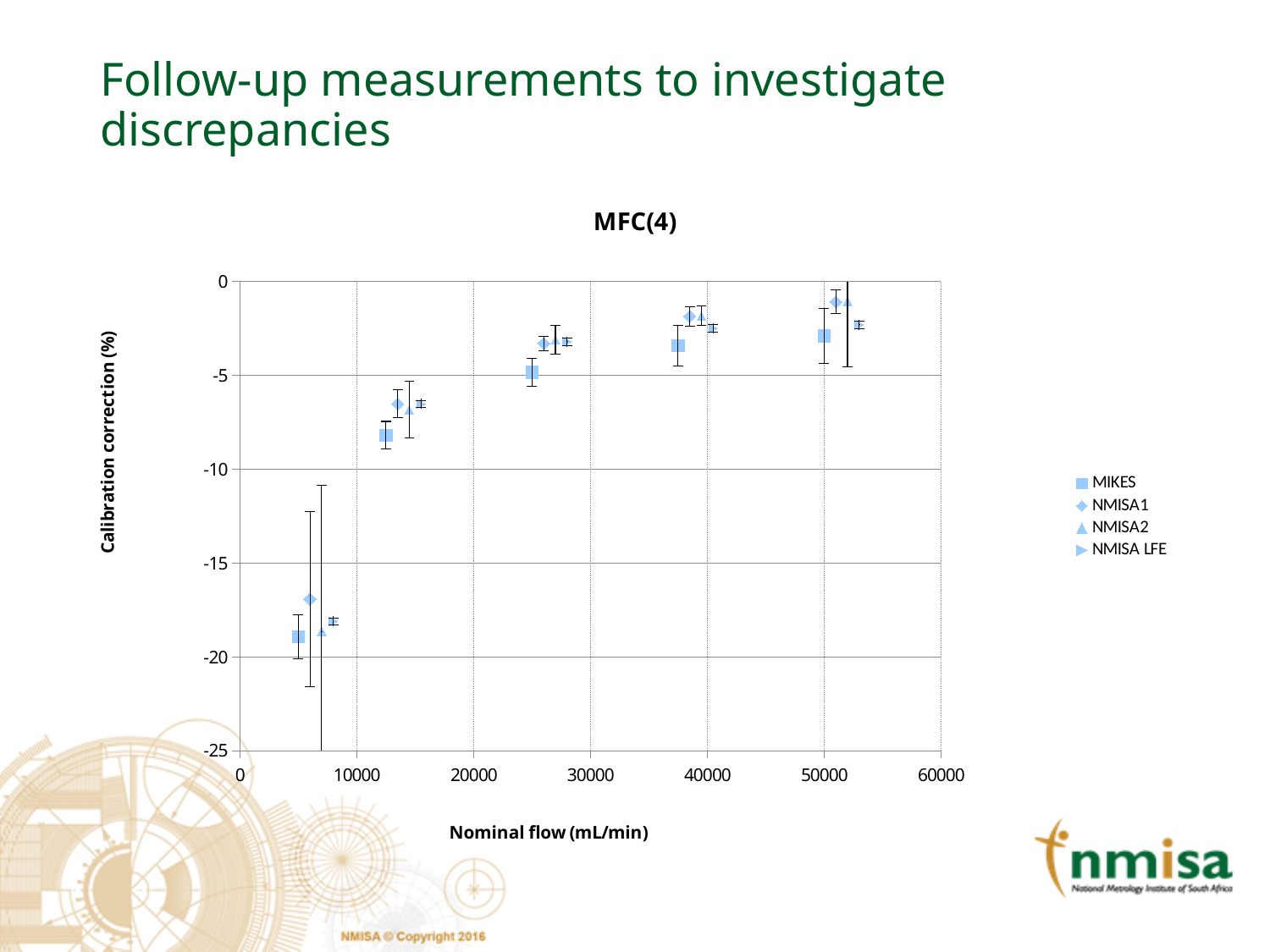
Which series shows the lowest calibration correction value on the chart? MIKES What is the label of the x axis? Nominal flow (mL/min) How many nominal flow levels (clusters of points) are plotted for each series? 5 Is the MIKES value at the nominal flow around 50000 mL/min greater or less than -5? greater What kind of chart is shown on the slide? scatter chart Is the MIKES value at the lowest nominal flow (around 5000 mL/min) greater or less than -15? less Is the NMISA LFE value at the highest nominal flow (around 53000 mL/min) greater or less than -5? greater What is the title of the chart? MFC(4) At the lowest nominal flow, which series has the higher calibration correction, MIKES or NMISA1? NMISA1 How many series does the legend list? 4 Do the calibration correction values rise or fall as nominal flow increases along the x axis? rise